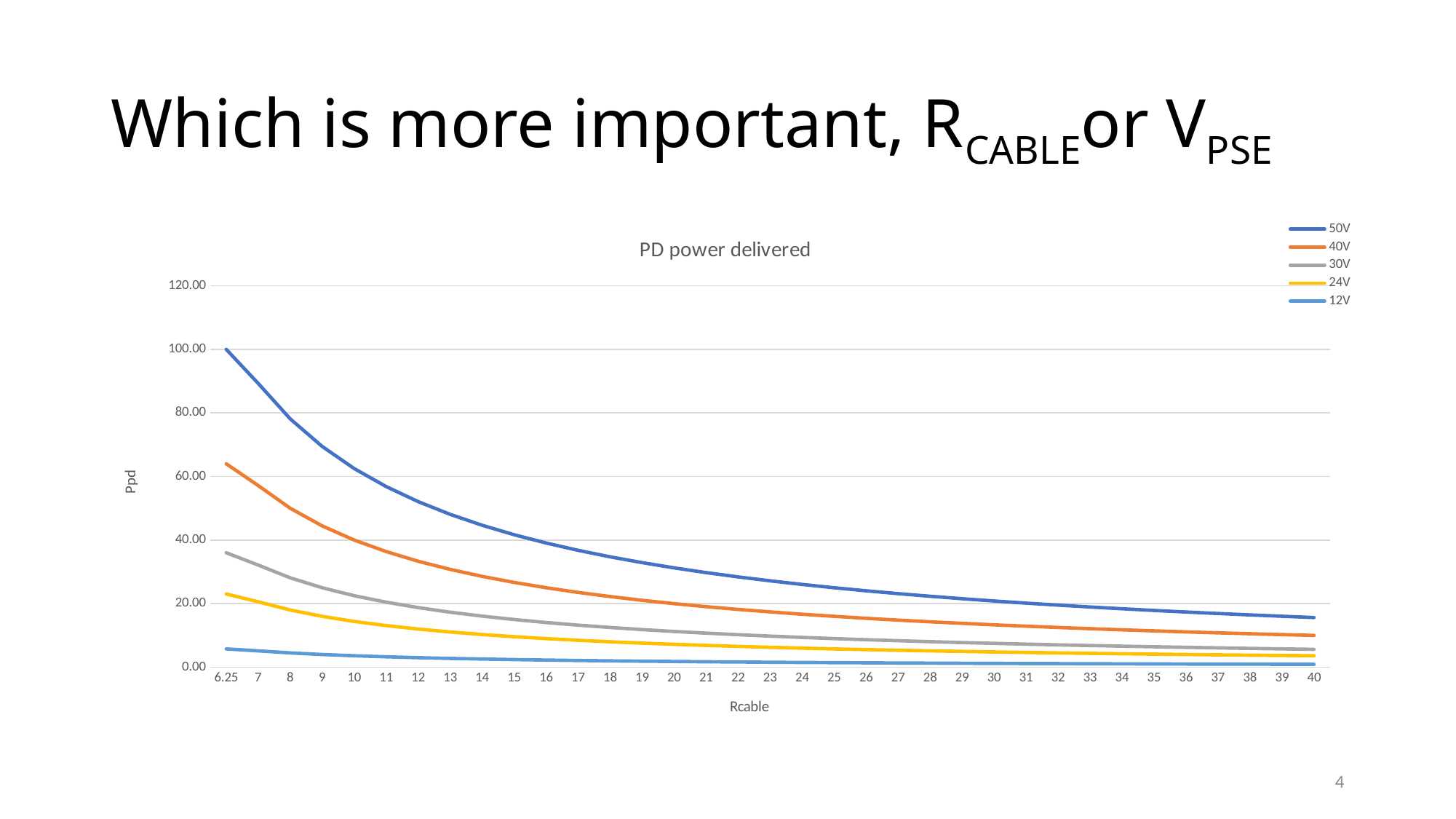
Which series has the highest Ppd values across the chart? 50V Do the Ppd values rise or fall as Rcable increases? fall What is the title of the chart? PD power delivered How many series does the legend list? 5 Is the Ppd value for the 40V series at Rcable 40 greater or less than 20.00? less Is the Ppd value for the 50V series at Rcable 20 greater or less than 20.00? greater Which series are listed in the legend? 50V, 40V, 30V, 24V, 12V At Rcable 20, which series has the larger Ppd value, 50V or 40V? 50V What type of chart is shown on the slide? line chart What is the Ppd value for the 50V series at Rcable 6.25? 100.00 Which series has the lowest Ppd values across the chart? 12V How many Rcable points are plotted along the x axis? 35